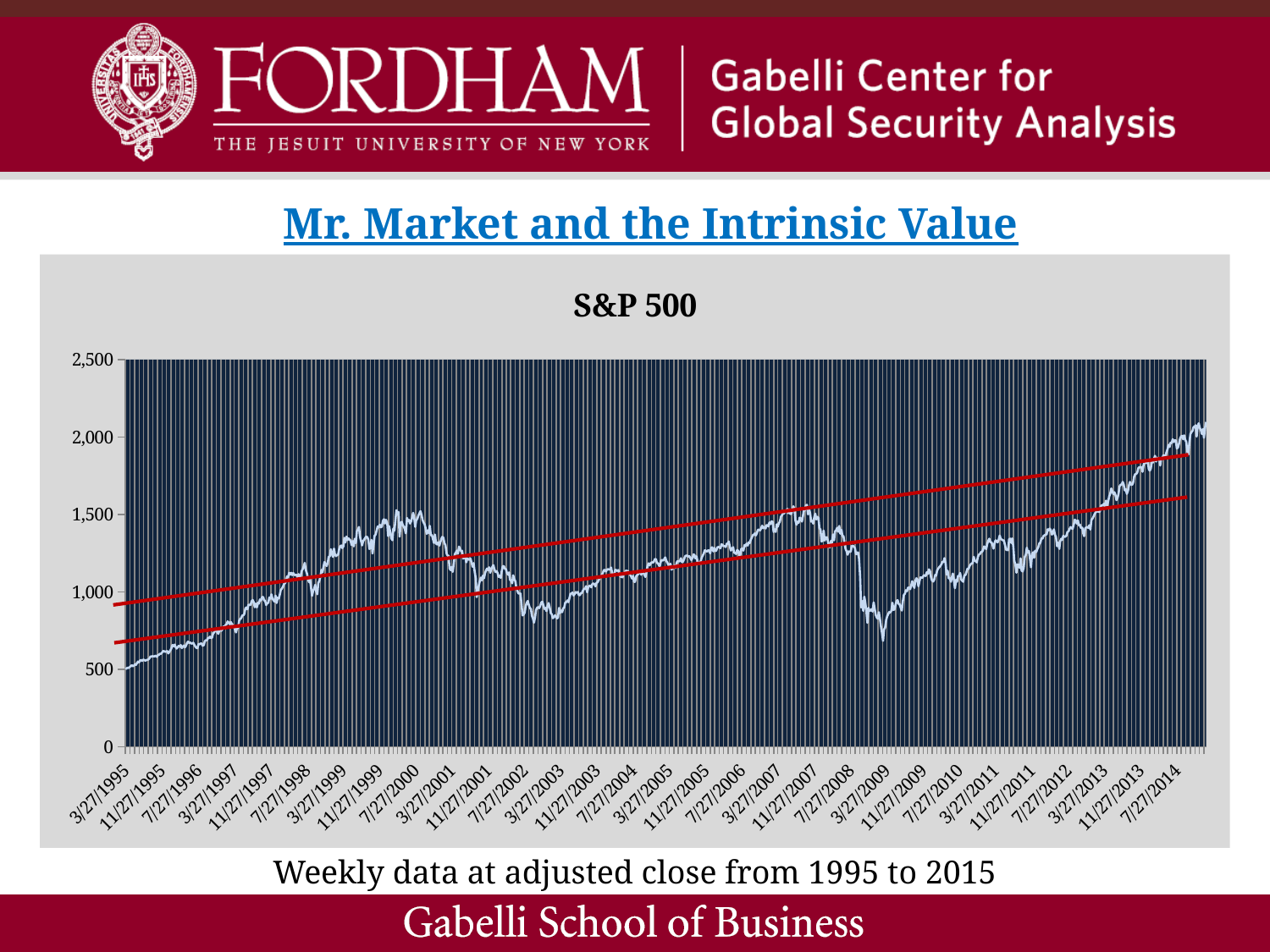
Is the value for 3/27/1995 greater or less than 1,000? less Is the value for 3/27/2003 greater or less than 1,000? less What is the first date label on the x axis? 3/27/1995 Overall, does the S&P 500 line rise or fall from the left of the x axis to the right? rise What is the highest value shown on the y axis? 2,500 Is the value for 7/27/2014 greater or less than 1,500? greater Does the S&P 500 line reach its highest point near the start or near the end of the x axis? near the end What is the title of the chart? S&P 500 Which is larger, the value for 7/27/2014 or the value for 3/27/1995? 7/27/2014 What kind of chart is shown on the slide? line chart